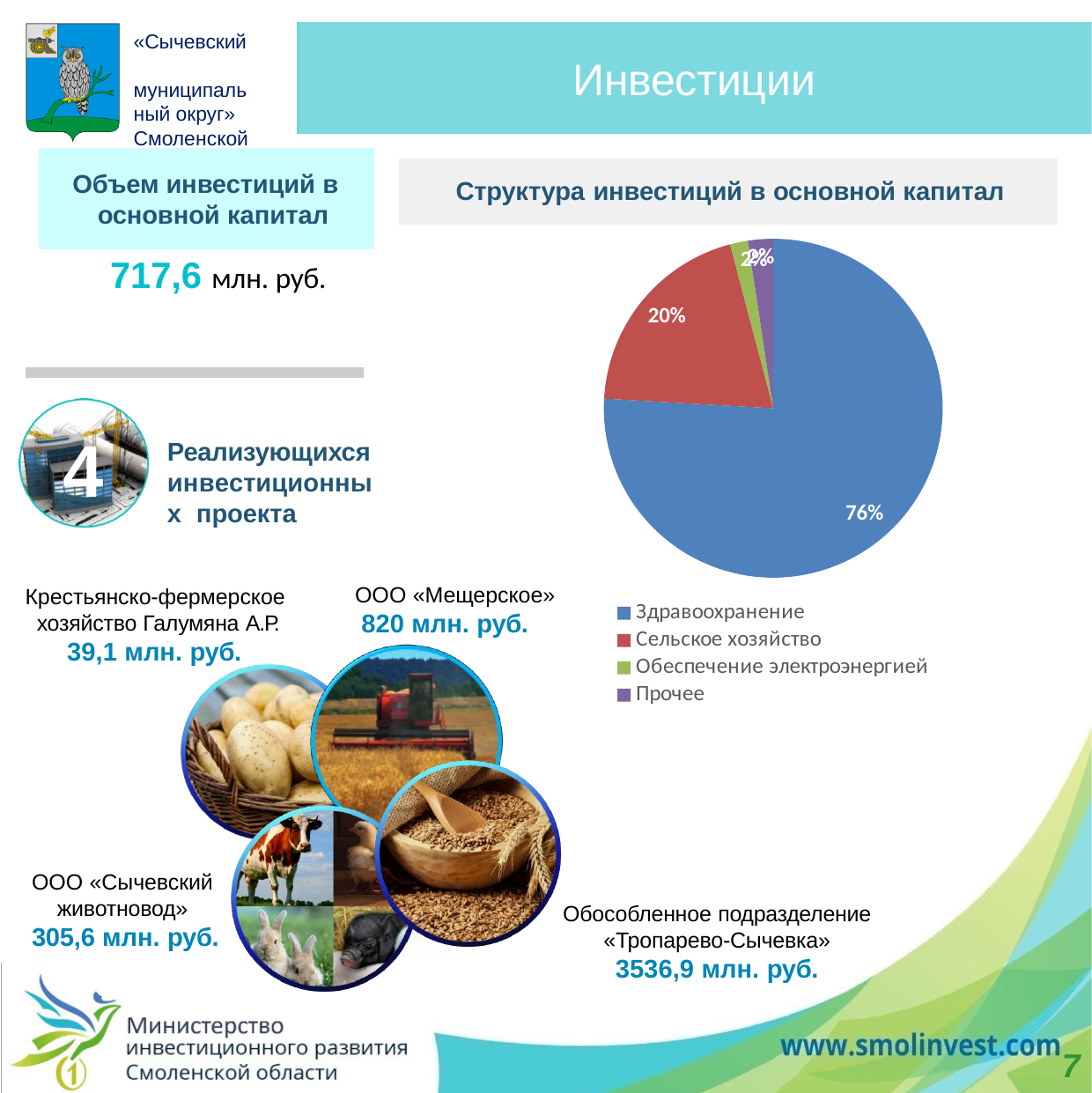
Which category has the largest slice in the pie chart? Здравоохранение Which slice is larger in the pie chart: «Сельское хозяйство» or «Обеспечение электроэнергией»? Сельское хозяйство What is the title of the pie chart on the slide? Структура инвестиций в основной капитал Is the share for «Сельское хозяйство» greater or less than 25%? less What colour is the «Здравоохранение» slice in the pie chart? blue By how many percentage points does the «Здравоохранение» slice exceed the «Сельское хозяйство» slice? 56 Is the share for «Здравоохранение» greater or less than 50%? greater What share of the pie chart does «Здравоохранение» account for? 76% How many categories does the legend of the pie chart list? 4 What share of the pie chart does «Сельское хозяйство» account for? 20% What kind of chart is shown under the title «Структура инвестиций в основной капитал»? pie chart